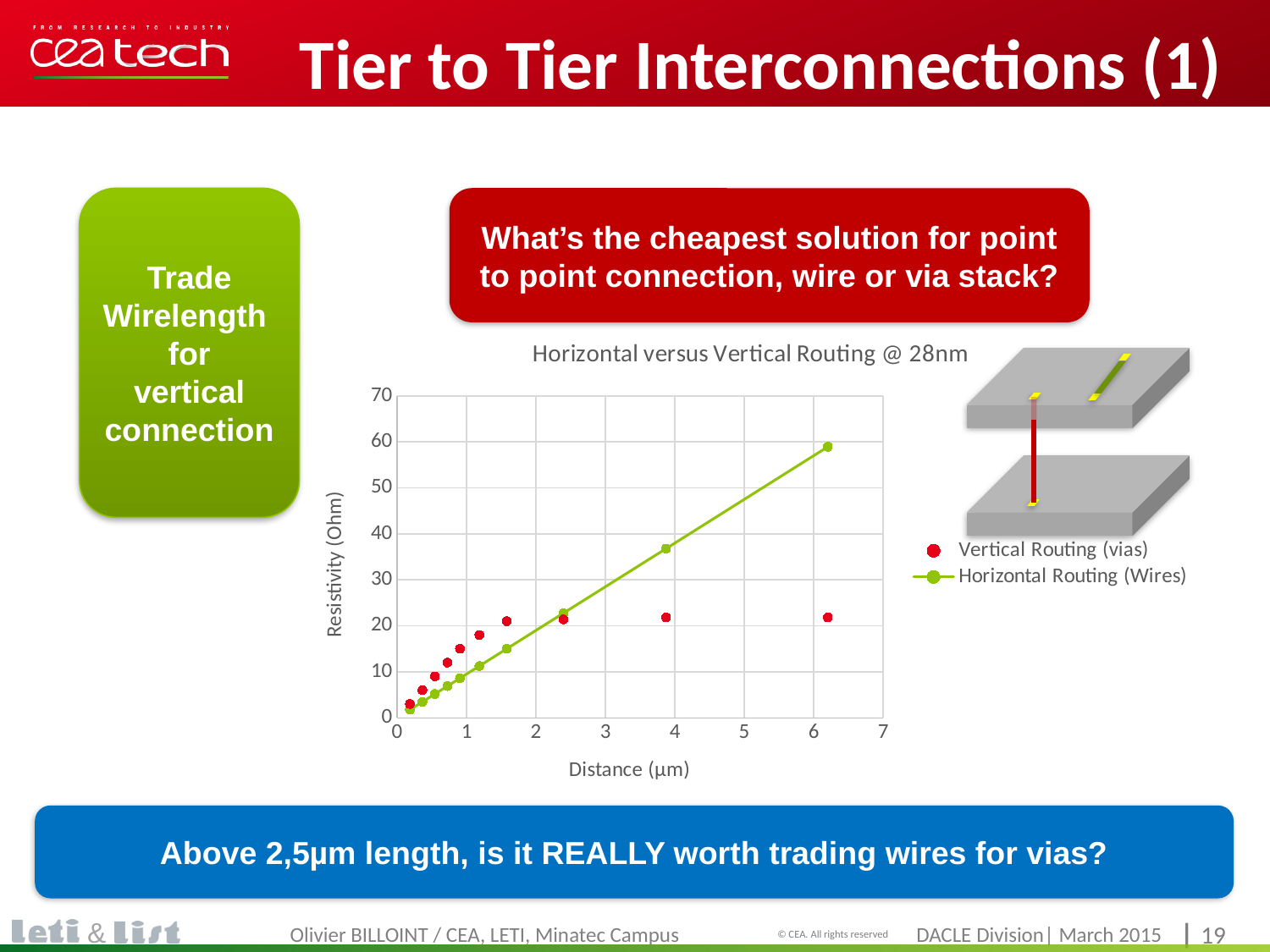
Is the resistivity of Horizontal Routing (Wires) at its farthest plotted distance (about 6 µm) greater or less than 50 Ohm? greater How many series does the chart legend list? 2 Which series reaches the highest resistivity value on the chart? Horizontal Routing (Wires) At a distance of about 6 µm, which series has the higher resistivity, Vertical Routing (vias) or Horizontal Routing (Wires)? Horizontal Routing (Wires) What is the title of the chart? Horizontal versus Vertical Routing @ 28nm What is the label of the y axis of the chart? Resistivity (Ohm) What is the highest value shown on the y axis of the chart? 70 At a distance of about 0.5 µm, which series has the higher resistivity, Vertical Routing (vias) or Horizontal Routing (Wires)? Vertical Routing (vias) What kind of chart is shown on the slide? scatter chart Is the resistivity of Horizontal Routing (Wires) at a distance of about 4 µm greater or less than 30 Ohm? greater Is the resistivity of Vertical Routing (vias) at its farthest plotted distance (about 6 µm) greater or less than 30 Ohm? less Does the resistivity of Horizontal Routing (Wires) rise or fall as distance increases? rise